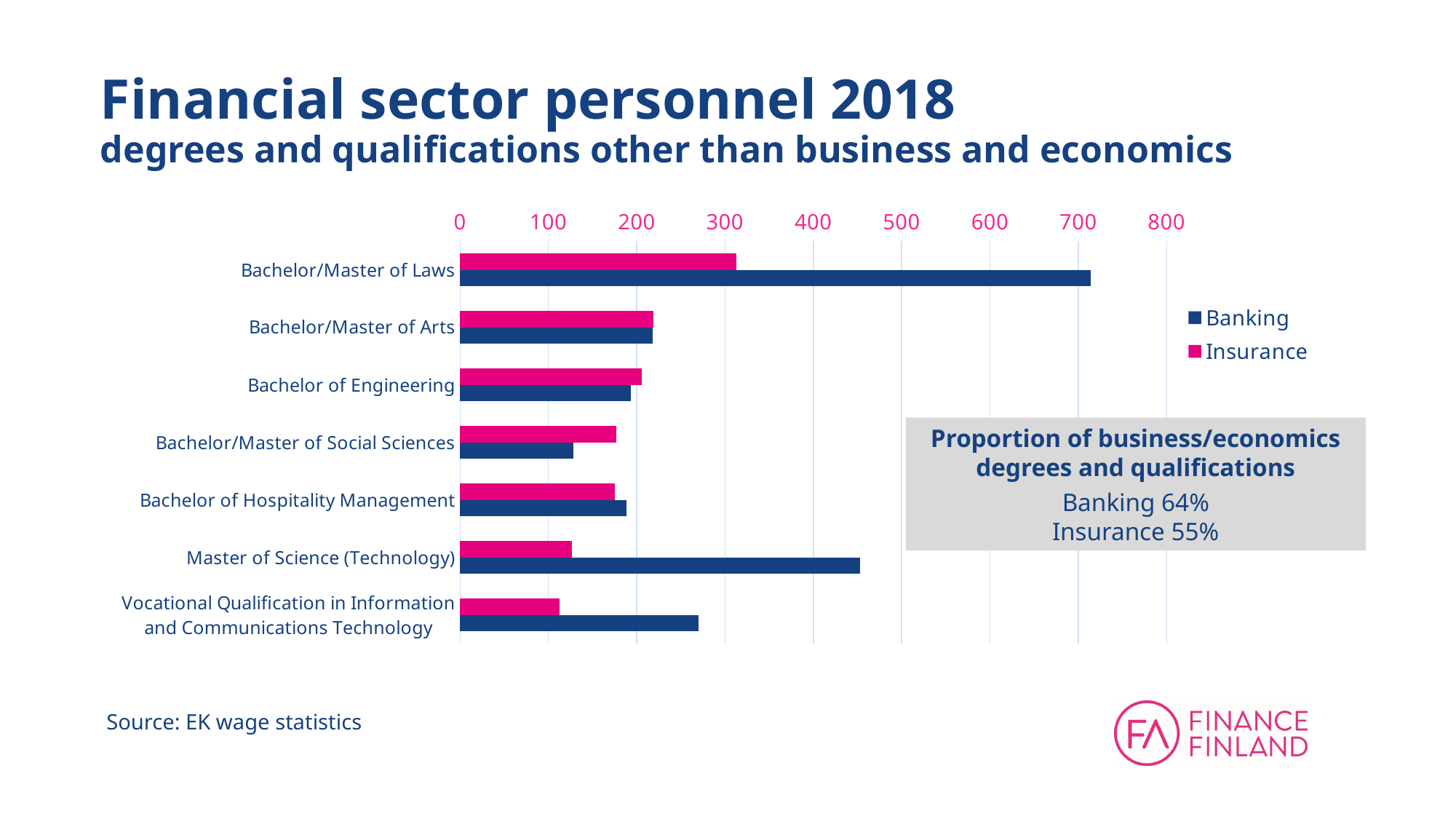
What kind of chart is shown on the slide? Bar chart For Vocational Qualification in Information and Communications Technology, which is larger: the Banking value or the Insurance value? Banking For Bachelor/Master of Social Sciences, which is larger: the Banking value or the Insurance value? Insurance Is the Banking value for Master of Science (Technology) greater or less than 400? greater Is the Banking value for Bachelor/Master of Laws greater or less than 600? greater Is the Insurance value for Vocational Qualification in Information and Communications Technology greater or less than 200? less How many series does the legend list? 2 What colour represents the Insurance series in the chart? Pink How many degree/qualification categories are plotted on the chart? 7 Which category has the lowest Banking value? Bachelor/Master of Social Sciences Which category has the highest Insurance value? Bachelor/Master of Laws Which category has the highest Banking value? Bachelor/Master of Laws